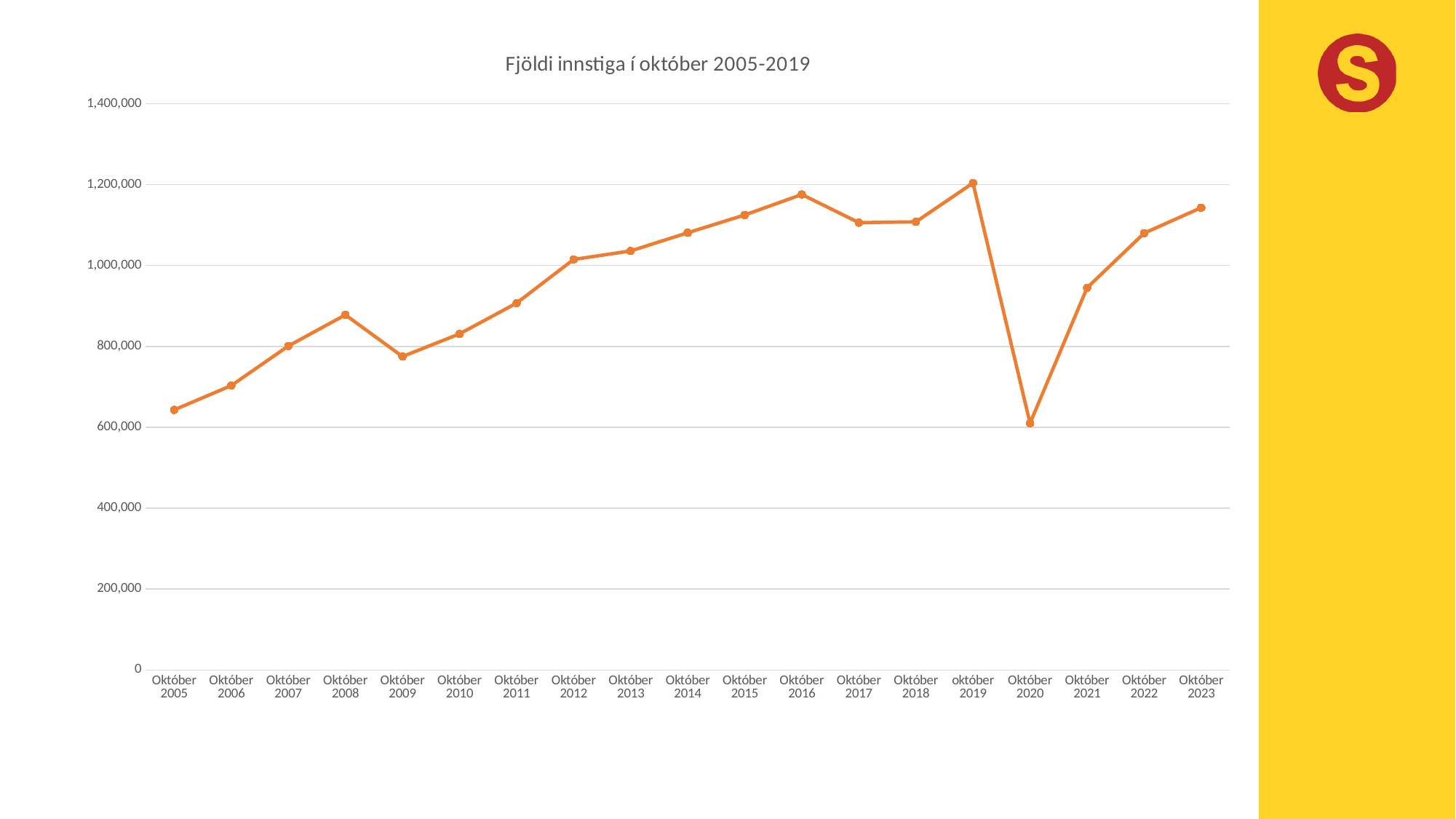
Which category has the lowest value? Október 2020 What is the title of the chart? Fjöldi innstiga í október 2005-2019 What kind of chart is shown on the slide? line chart Is the value for Október 2021 greater or less than 1,000,000? less How many data points are plotted on the chart? 19 Is the value for Október 2016 greater or less than 1,000,000? greater Is the value for Október 2005 greater or less than 600,000? greater Which category has the highest value? október 2019 Do the values rise or fall from Október 2005 to Október 2008? rise Which is larger, the value for Október 2008 or Október 2009? Október 2008